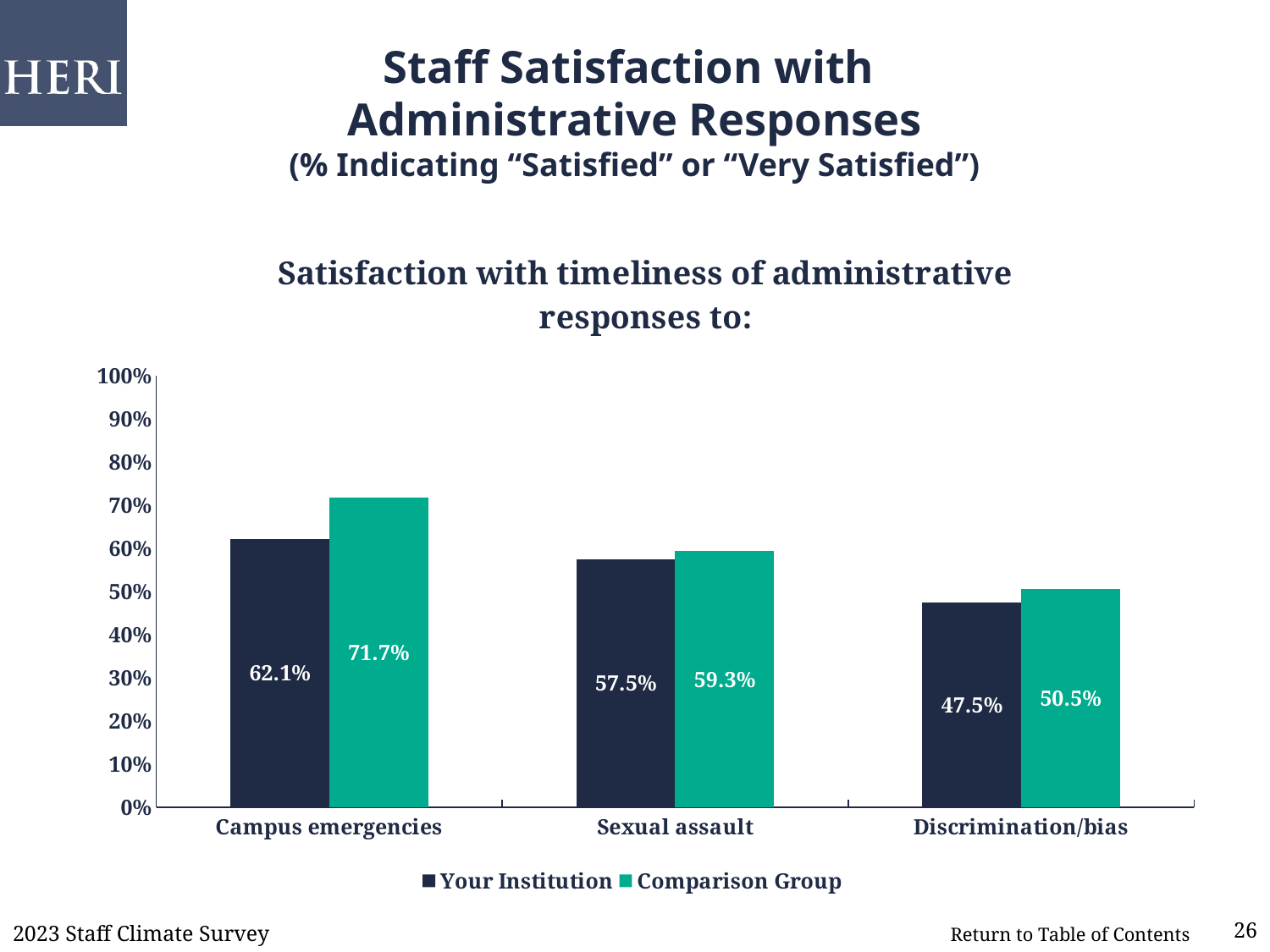
What is the value for Comparison Group for Sexual assault? 59.3% What is the difference between the Comparison Group and Your Institution values for Discrimination/bias? 3.0% What is the value for Your Institution for Campus emergencies? 62.1% What is the difference between the Comparison Group and Your Institution values for Campus emergencies? 9.6% Which category has the lowest value for Comparison Group? Discrimination/bias Which category has the highest value for Your Institution? Campus emergencies What is the value for Comparison Group for Discrimination/bias? 50.5% For Sexual assault, which is larger: Your Institution or Comparison Group? Comparison Group Do the Your Institution values rise or fall from left to right across the categories? Fall What kind of chart is shown on the slide? Bar chart How many categories are shown on the x axis? 3 How many series does the legend list? 2